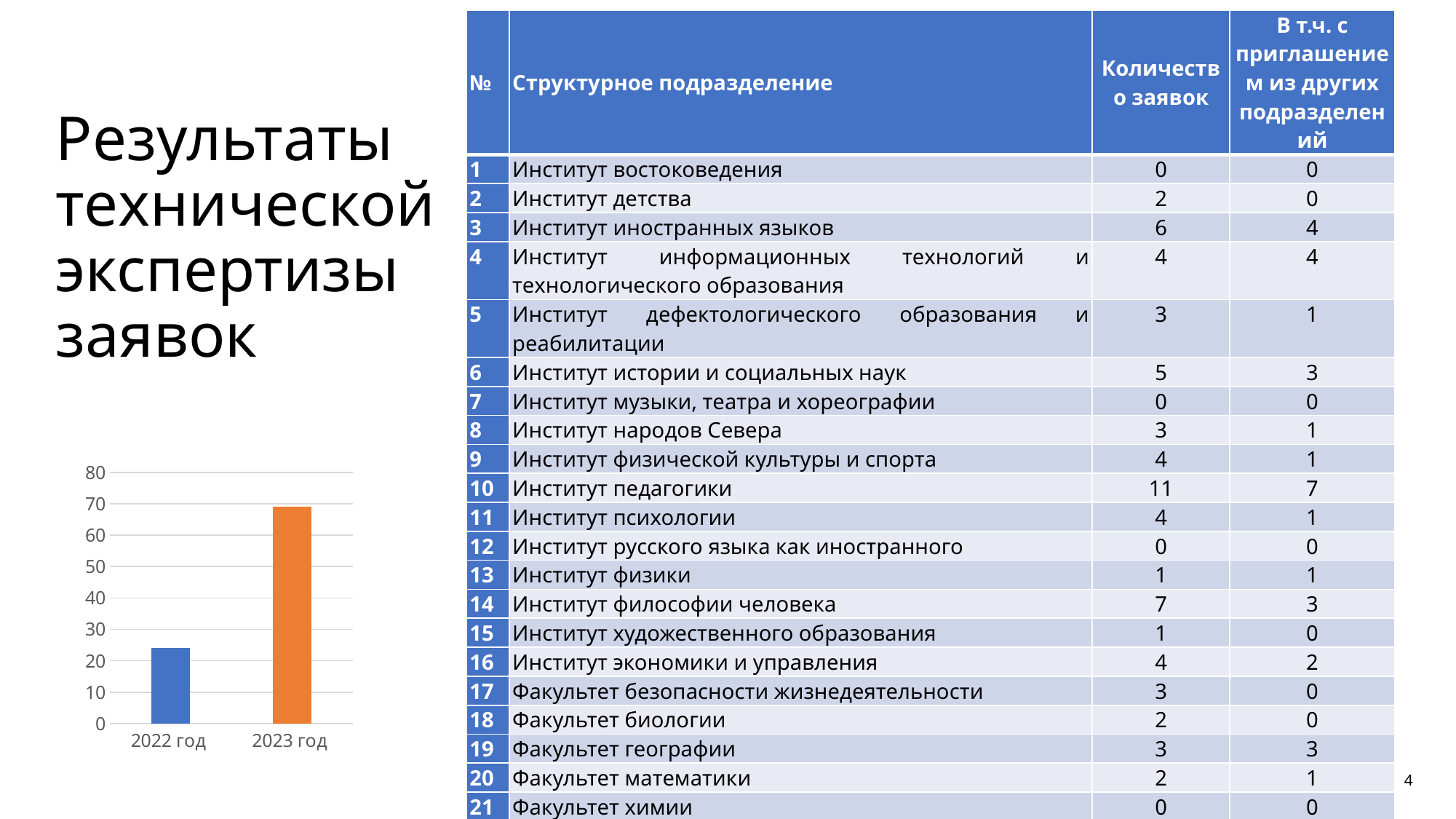
Do the values in the chart rise or fall from 2022 год to 2023 год? rise Is the value for 2022 год greater or less than 20? greater Is the value for 2023 год greater or less than 80? less How many bars does the chart show? 2 What colour is the bar for 2023 год in the chart? orange Which year has the highest bar in the chart? 2023 год Is the value for 2022 год greater or less than 30? less Which year has the lowest bar in the chart? 2022 год What is the highest value shown on the chart's vertical axis? 80 What kind of chart is shown on the slide? bar chart Which is larger in the chart, the value for 2022 год or for 2023 год? 2023 год